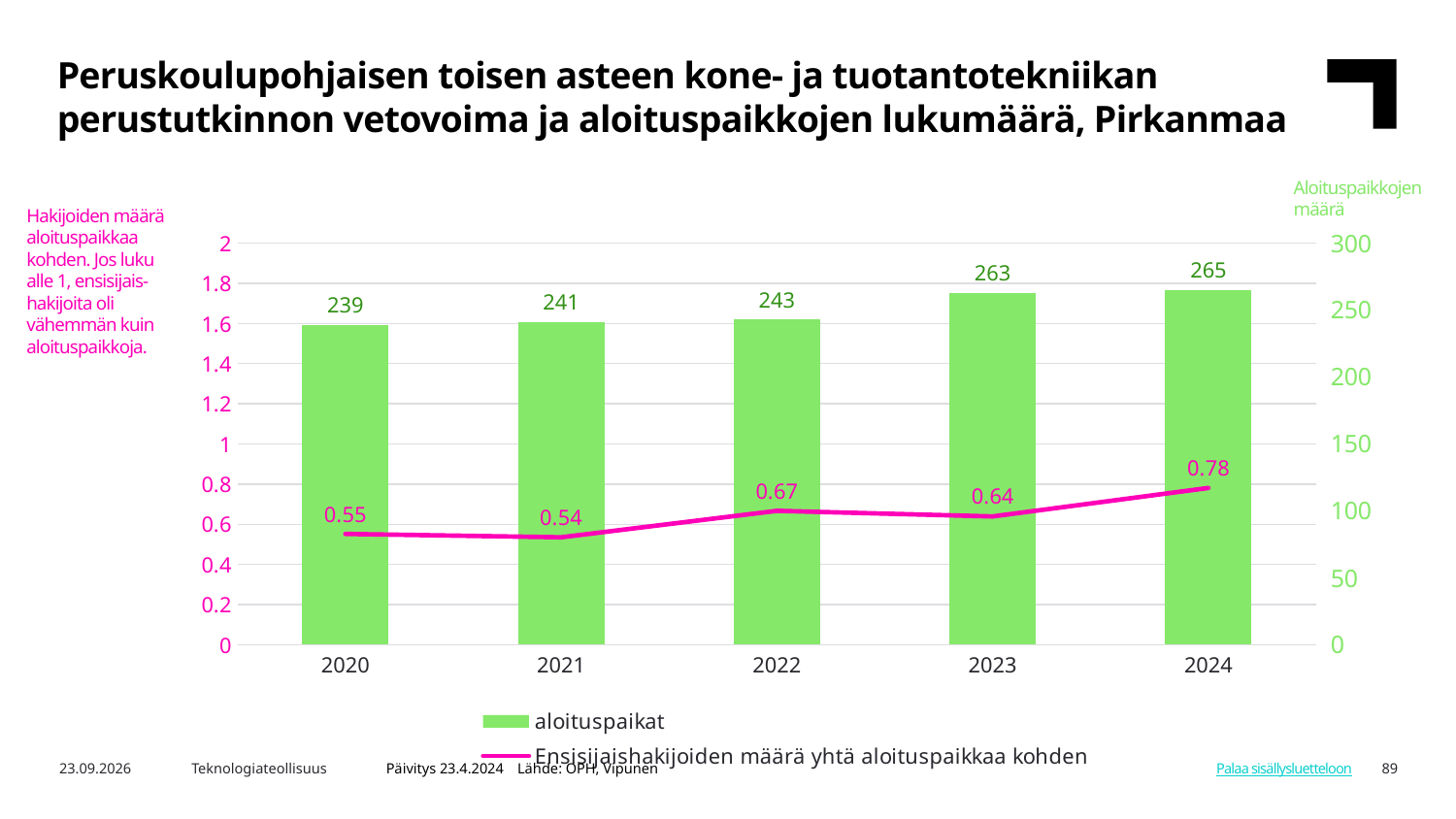
Does the aloituspaikat series rise or fall from 2020 to 2024? rise How many series does the legend list? 2 Is the aloituspaikat value for 2023 greater or less than 250? greater Which is larger, the Ensisijaishakijoiden määrä yhtä aloituspaikkaa kohden value for 2022 or for 2023? 2022 What is the value of aloituspaikat for 2020? 239 Which year has the lowest value of Ensisijaishakijoiden määrä yhtä aloituspaikkaa kohden? 2021 What is the difference in aloituspaikat between 2023 and 2022? 20 How many years are shown on the x axis? 5 What kind of chart is used for the aloituspaikat series? bar chart What is the value of aloituspaikat for 2022? 243 What is the value of Ensisijaishakijoiden määrä yhtä aloituspaikkaa kohden for 2024? 0.78 Which year has the highest value of aloituspaikat? 2024